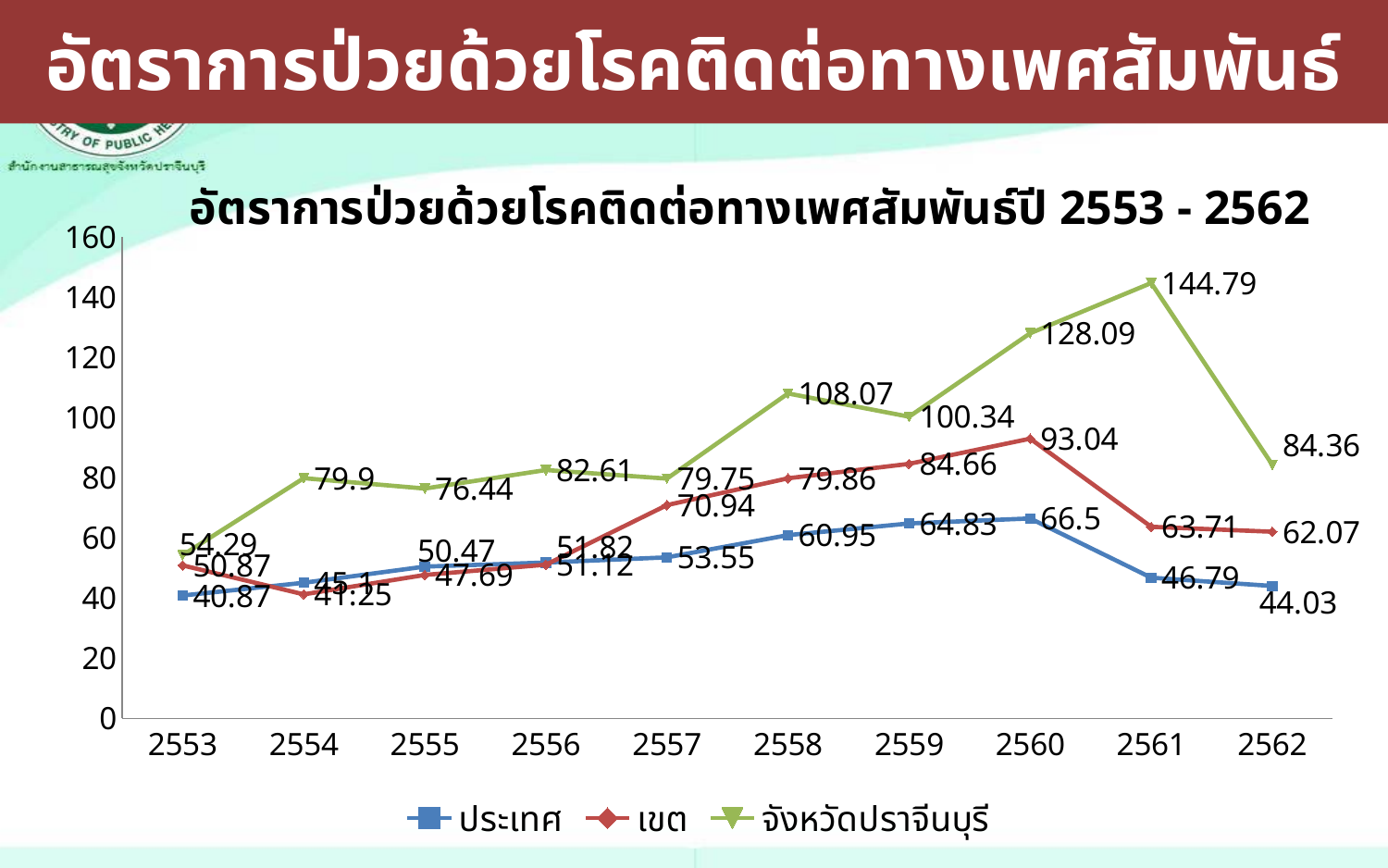
What is the difference between จังหวัดปราจีนบุรี and เขต in 2562? 22.29 Which series has the higher value in 2559, เขต or ประเทศ? เขต How many series does the legend list? 3 What is the value for ประเทศ in 2562? 44.03 How many years are shown on the x axis? 10 What is the value for เขต in 2560? 93.04 What type of chart is shown on the slide? line chart In which year does จังหวัดปราจีนบุรี reach its highest value? 2561 Is the value for จังหวัดปราจีนบุรี in 2560 greater or less than 120? greater What is the value for จังหวัดปราจีนบุรี in 2558? 108.07 What is the value for จังหวัดปราจีนบุรี in 2561? 144.79 In which year is the value for ประเทศ lowest? 2553